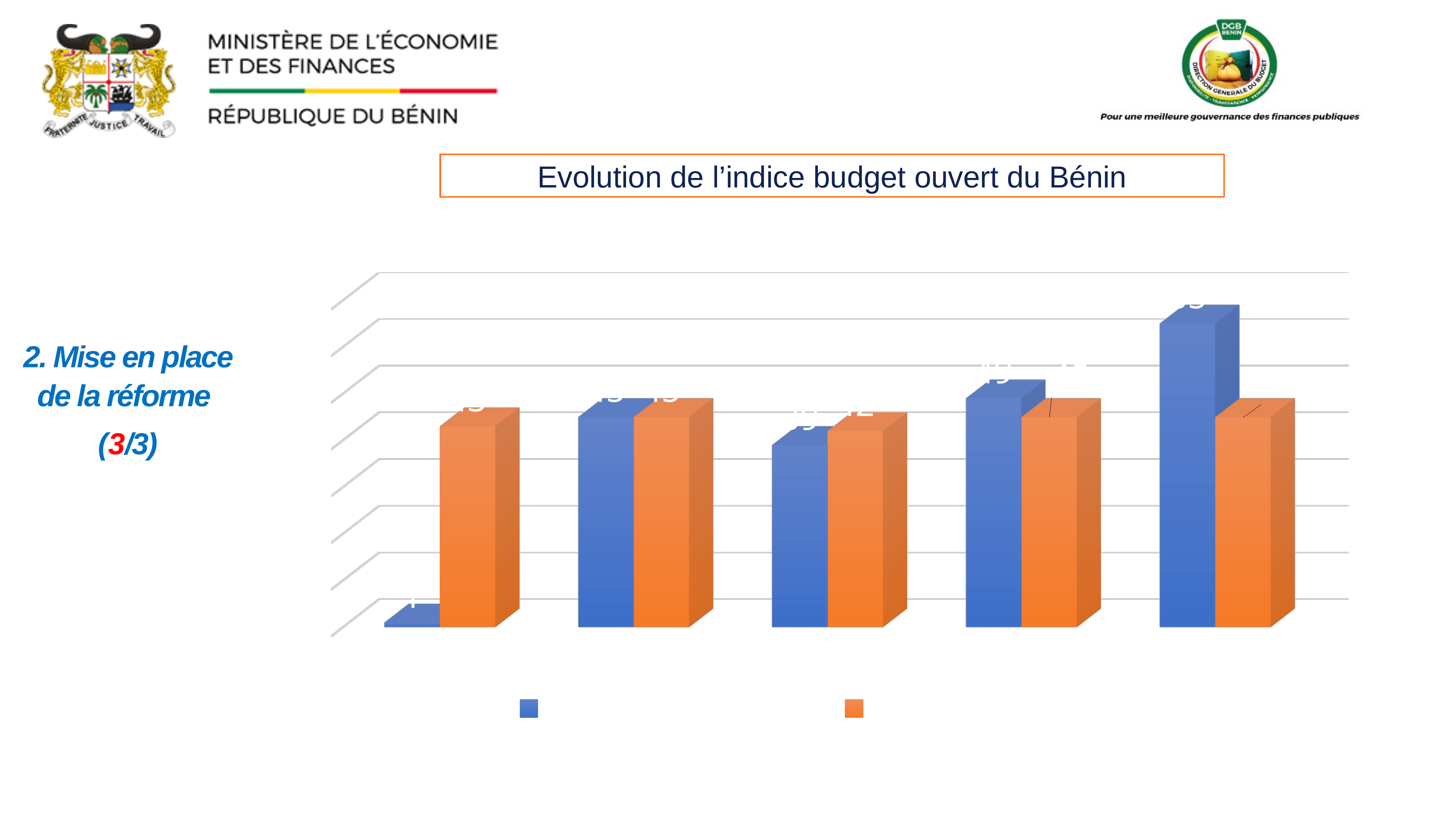
Which bar is the shortest in the chart? the blue bar in the leftmost group How many series does the legend list? 2 Does the blue series generally rise or fall from the leftmost group to the rightmost group? rise What is the title of the chart? Evolution de l'indice budget ouvert du Bénin In the leftmost group of bars, which series is larger, blue or orange? orange What kind of chart is shown on the slide? bar chart In the rightmost group of bars, which series is larger, blue or orange? blue Which bar is the tallest in the chart? the blue bar in the rightmost group How many groups of bars are plotted along the x axis? 5 In the fourth group of bars from the left, which series is larger, blue or orange? blue Which colours are used for the two series in the chart? blue and orange